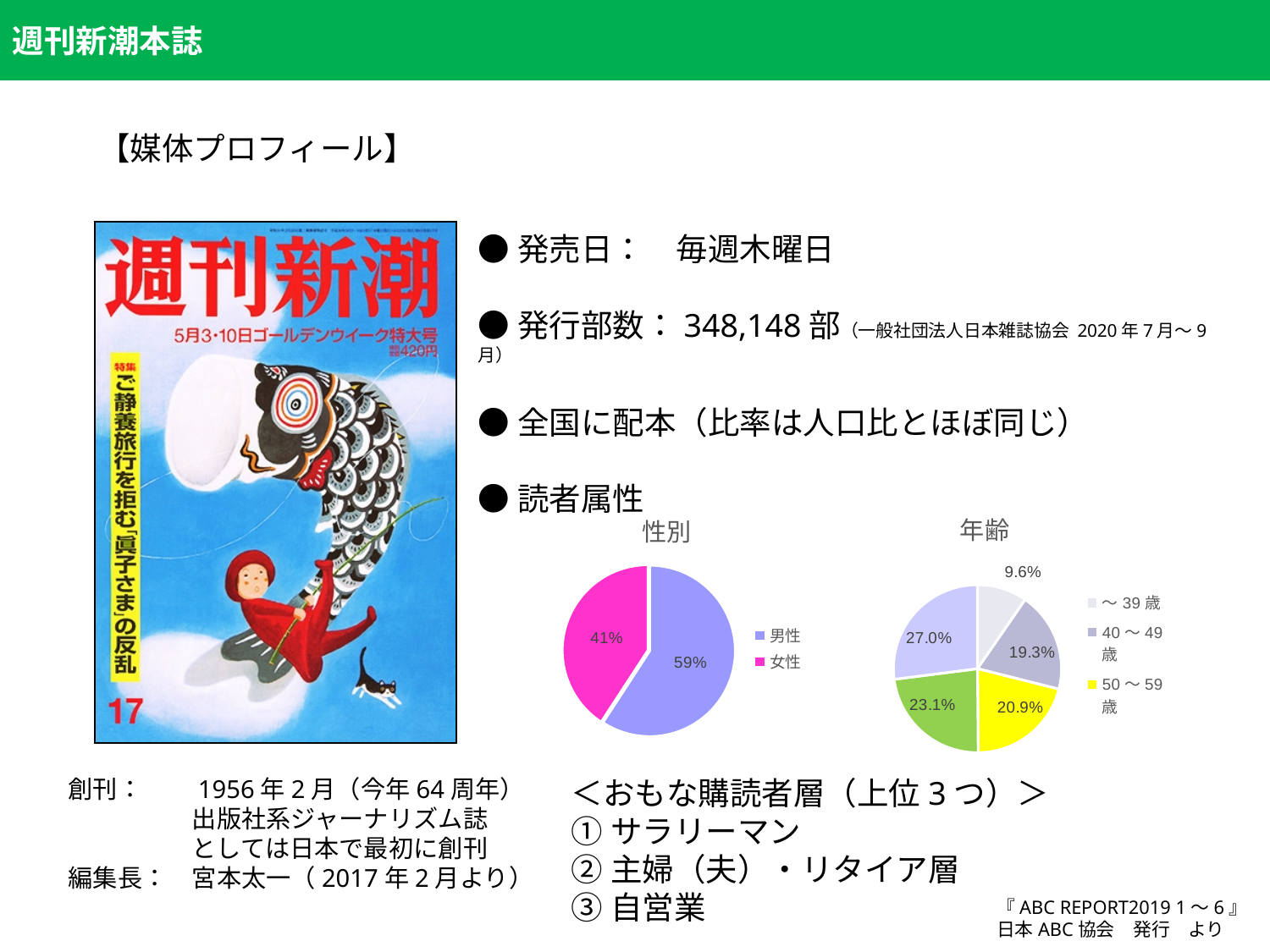
In the 年齢 chart, how many slices does the pie have? 5 In the 性別 chart, what percentage is 女性? 41% In the 年齢 chart, what percentage is 50～59歳? 20.9% What kind of chart is the 性別 chart? Pie chart In the 年齢 chart, what percentage is ～39歳? 9.6% How many series does the legend of the 性別 chart list? 2 In the 年齢 chart, what percentage is 40～49歳? 19.3% In the 年齢 chart, what is the largest percentage shown on any slice? 27.0% In the 年齢 chart, what is the difference in percentage points between 50～59歳 and 40～49歳? 1.6 In the 性別 chart, which category has the larger share, 男性 or 女性? 男性 In the 性別 chart, what percentage is 男性? 59% In the 性別 chart, what is the difference in percentage points between 男性 and 女性? 18